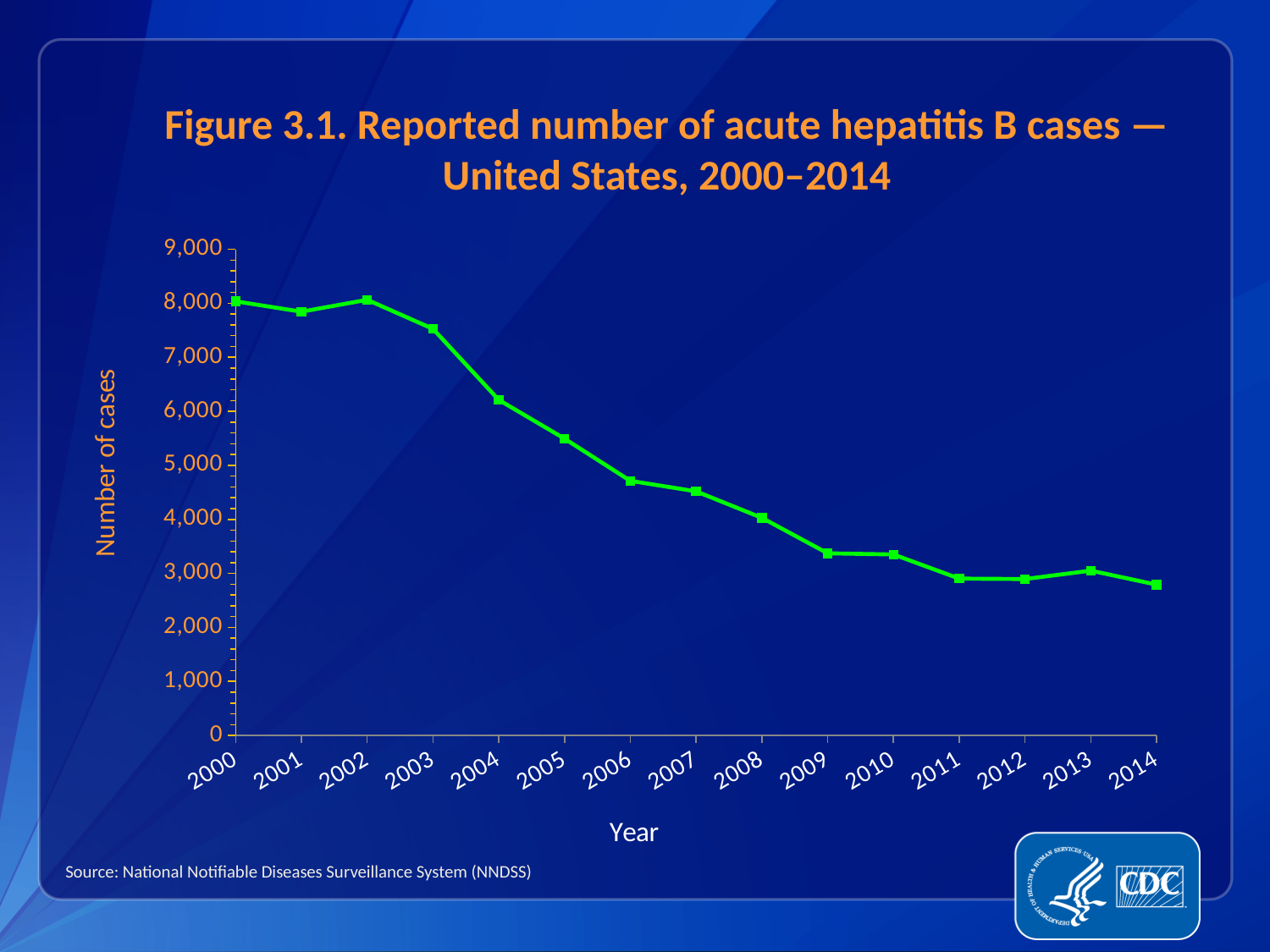
Is the number of cases in 2003 greater or less than 7,000? greater Is the number of cases in 2004 greater or less than 6,000? greater Is the number of cases in 2005 greater or less than 6,000? less How many years (data points) are plotted on the chart? 15 Overall, do the reported acute hepatitis B cases rise or fall from 2000 to 2014? Fall What kind of chart is shown on the slide? Line chart What is the title of the chart? Figure 3.1. Reported number of acute hepatitis B cases — United States, 2000–2014 What is the label on the vertical axis of the chart? Number of cases Which year had more reported cases, 2003 or 2004? 2003 Which year had more reported cases, 2000 or 2014? 2000